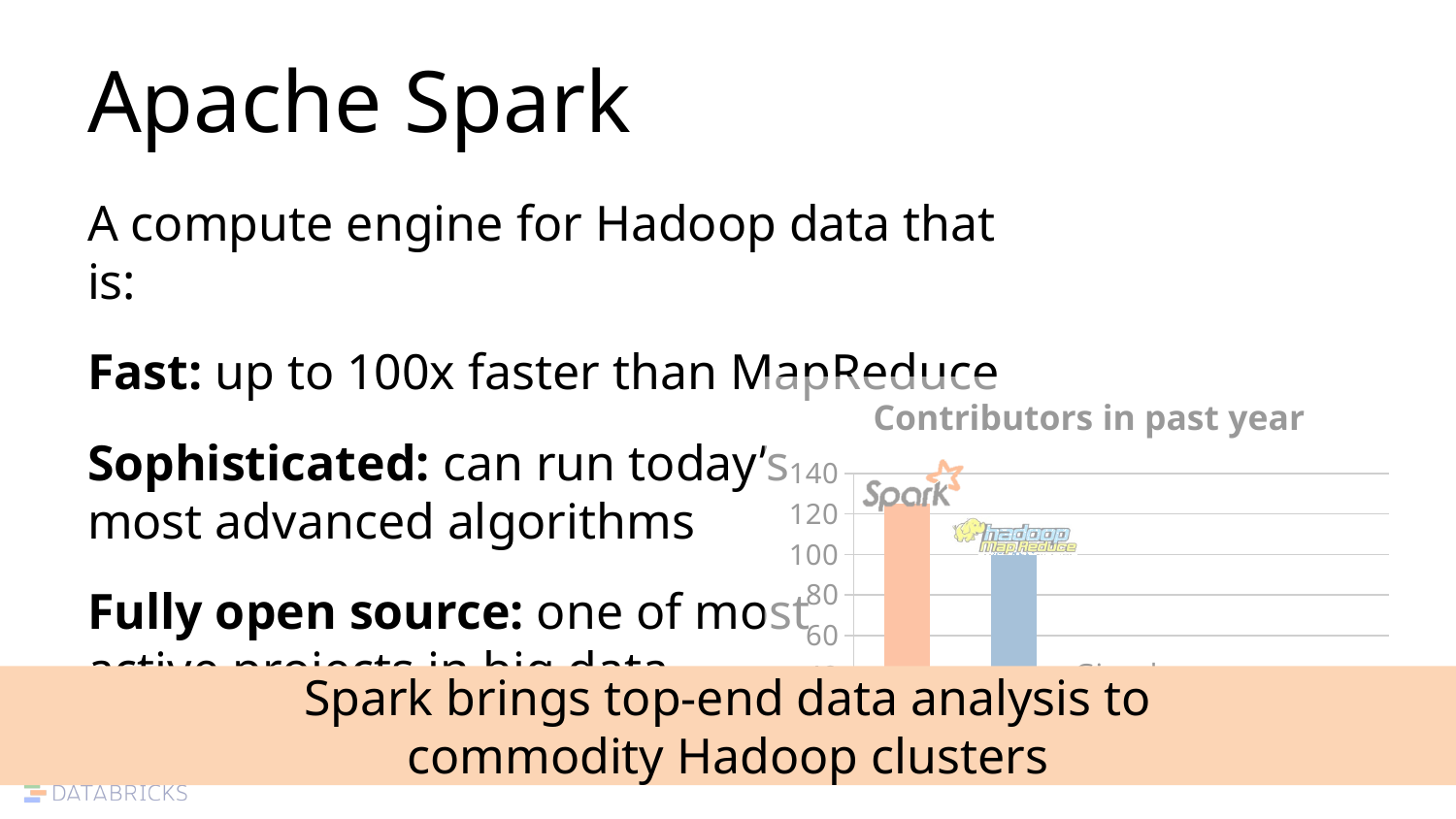
In the 'Contributors in past year' chart, is the value for Spark greater or less than 140? less In the 'Contributors in past year' chart, is the value for Spark greater or less than 120? greater In the 'Contributors in past year' chart, which project has the highest bar? Spark What colour is the Spark bar in the 'Contributors in past year' chart? orange In the 'Contributors in past year' chart, which is larger: the value for Spark or the value for Hadoop MapReduce? Spark In the 'Contributors in past year' chart, is the value for Hadoop MapReduce greater or less than 80? greater What is the title of the chart on the slide? Contributors in past year What kind of chart is shown on the slide? bar chart